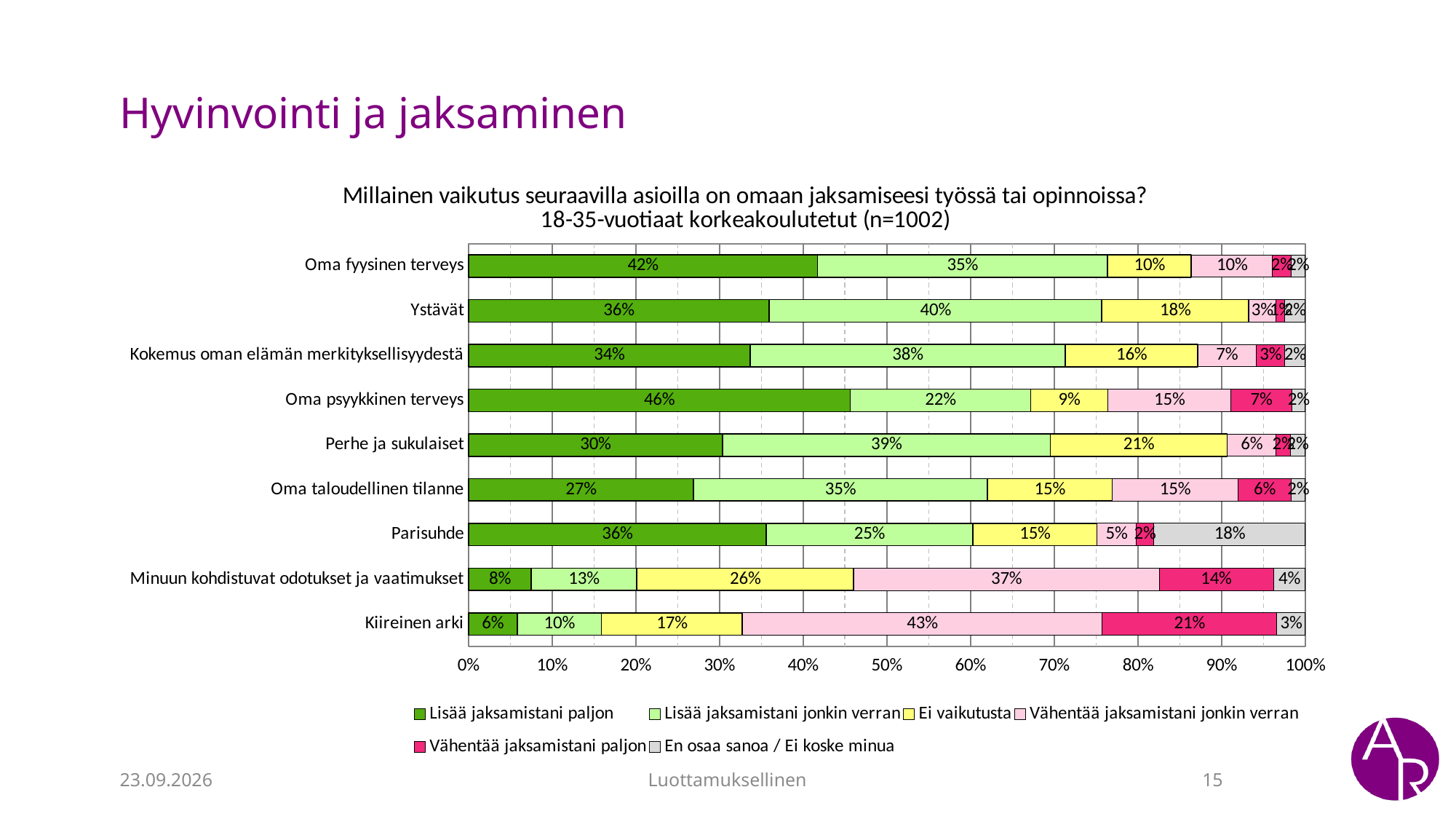
What is the 'Ei vaikutusta' value for 'Perhe ja sukulaiset'? 21% What is the difference between the 'Lisää jaksamistani paljon' values for 'Oma fyysinen terveys' and 'Oma taloudellinen tilanne'? 15% What kind of chart is shown on the slide? Stacked bar chart Which category has the lowest 'Lisää jaksamistani paljon' value? Kiireinen arki How many series does the legend list? 6 How many categories are shown on the chart? 9 What percentage of respondents said 'Oma psyykkinen terveys' increases their coping a lot (Lisää jaksamistani paljon)? 46% Which category has the highest 'Vähentää jaksamistani paljon' value? Kiireinen arki What is the 'Vähentää jaksamistani jonkin verran' value for 'Kiireinen arki'? 43% Which category has the highest 'Lisää jaksamistani paljon' value? Oma psyykkinen terveys What is the 'En osaa sanoa / Ei koske minua' value for 'Parisuhde'? 18% Which is larger: the 'Lisää jaksamistani jonkin verran' value for 'Ystävät' or for 'Parisuhde'? Ystävät